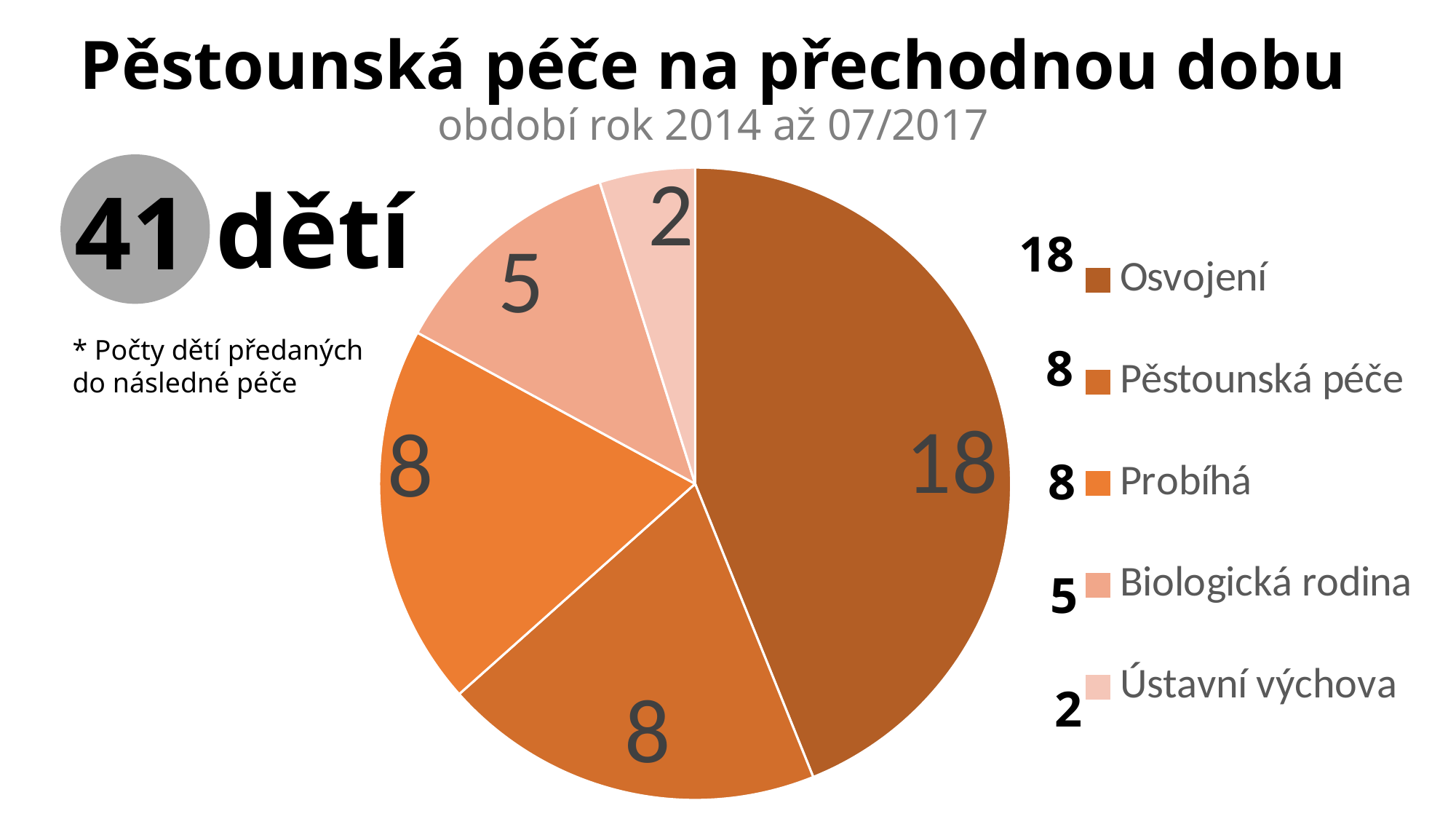
What is the value for Ústavní výchova? 2 What kind of chart is shown on the slide? pie chart What is the total number of children represented by the pie chart? 41 What is the value for Osvojení? 18 What is the title of the slide containing the pie chart? Pěstounská péče na přechodnou dobu What is the value for Biologická rodina? 5 Which is larger, the value for Osvojení or the value for Biologická rodina? Osvojení What is the difference between the values for Biologická rodina and Ústavní výchova? 3 How many slices does the pie chart have? 5 Which category has the largest slice of the pie? Osvojení What is the difference between the values for Osvojení and Probíhá? 10 Which category has the smallest slice of the pie? Ústavní výchova